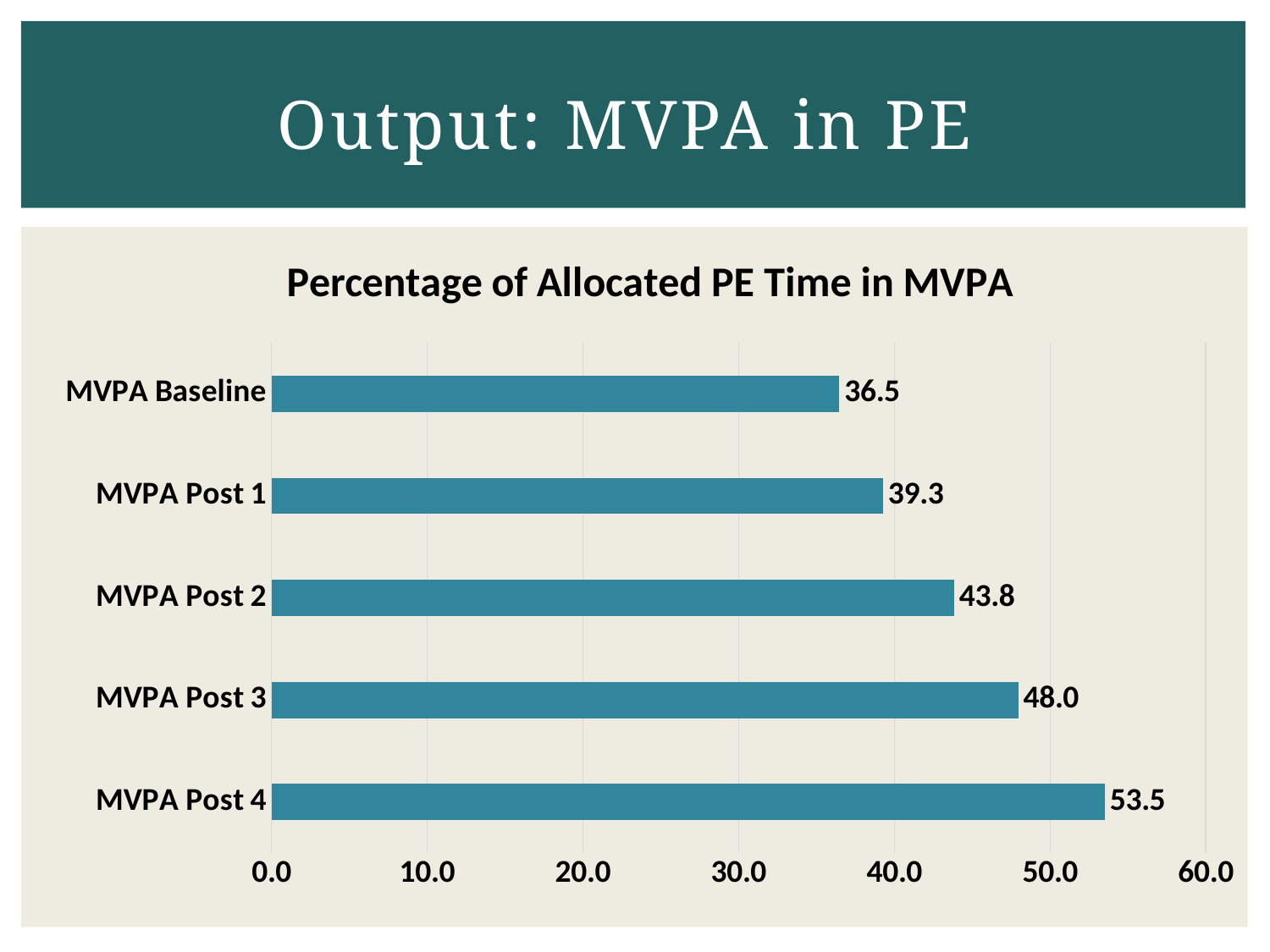
What is the title of the chart? Percentage of Allocated PE Time in MVPA What is the difference between the values for MVPA Post 3 and MVPA Post 1? 8.7 How many categories are shown in the chart? 5 Which category has the lowest value? MVPA Baseline Which category has the highest value? MVPA Post 4 What is the difference between the values for MVPA Post 4 and MVPA Baseline? 17.0 What is the value for MVPA Post 4? 53.5 What kind of chart is shown on the slide? bar chart Is the value for MVPA Post 2 greater or less than 40.0? greater What is the value for MVPA Post 2? 43.8 Which is larger, the value for MVPA Post 1 or MVPA Post 3? MVPA Post 3 What is the value for MVPA Baseline? 36.5